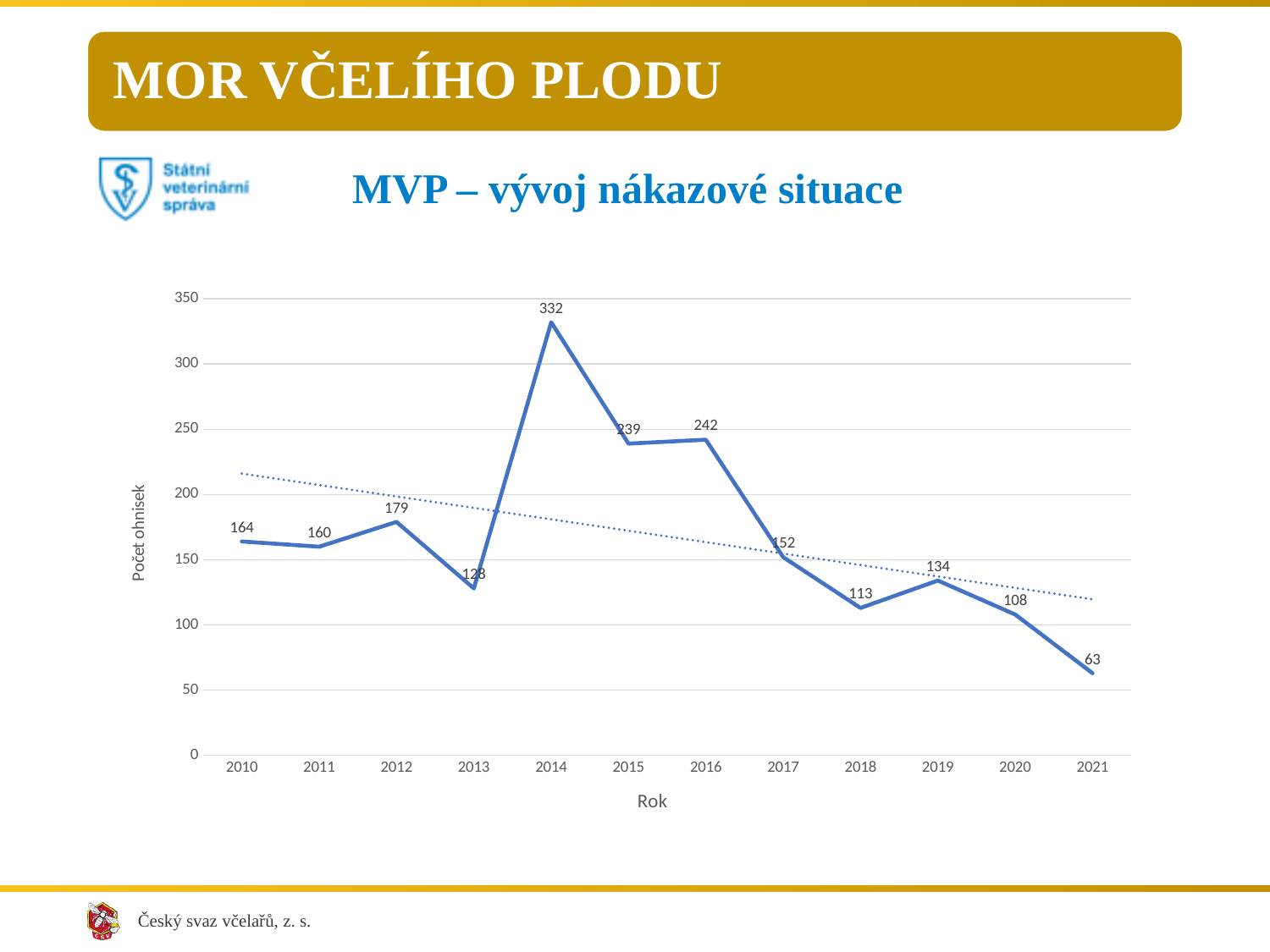
What is the number of outbreaks (Počet ohnisek) for 2014? 332 What is the value plotted for 2010? 164 What is the difference between the values for 2014 and 2015? 93 Do the values generally rise or fall from 2016 to 2021? fall How many years are plotted on the x axis? 12 Which year has the lowest value? 2021 What is the value plotted for 2021? 63 What type of chart is shown on the slide? line chart Which year has the highest value? 2014 Which year has the larger value, 2018 or 2019? 2019 Is the value for 2016 greater or less than 200? greater What is the label of the y axis? Počet ohnisek